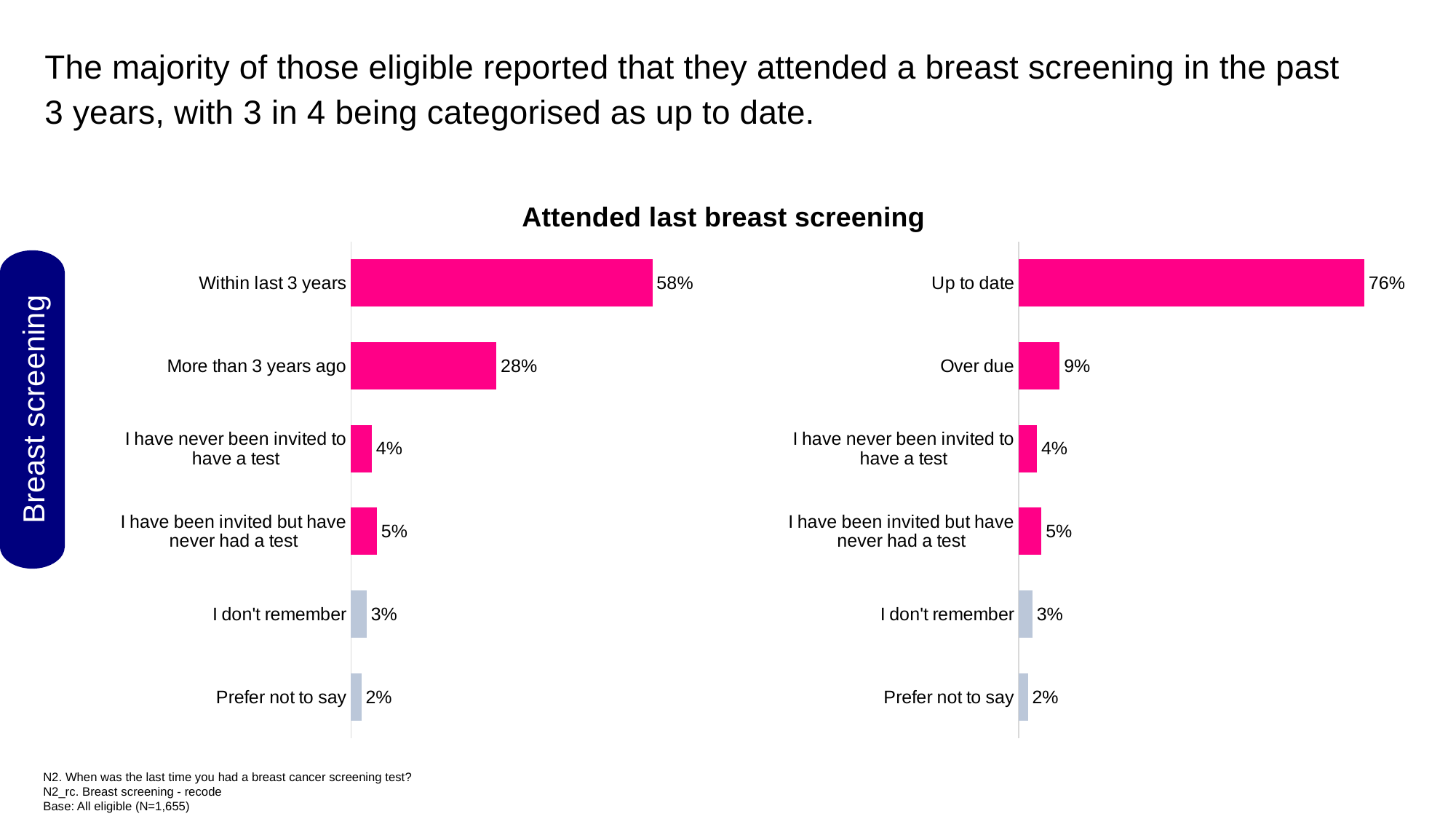
What kind of chart is used on this slide? Bar chart What is the title shown above the charts? Attended last breast screening How many categories does the left chart show? 6 In the left chart, what is the value for 'Within last 3 years'? 58% In the left chart, what is the difference between 'Within last 3 years' and 'More than 3 years ago'? 30 percentage points In the left chart, what is the value for 'More than 3 years ago'? 28% In the right chart, which category has the lowest value? Prefer not to say In the left chart, which is larger: 'I have never been invited to have a test' or 'I have been invited but have never had a test'? I have been invited but have never had a test In the right chart, what is the difference between 'Up to date' and 'Over due'? 67 percentage points In the right chart, what is the value for 'Up to date'? 76% In the right chart, what is the value for 'Over due'? 9% In the left chart, which category has the highest value? Within last 3 years